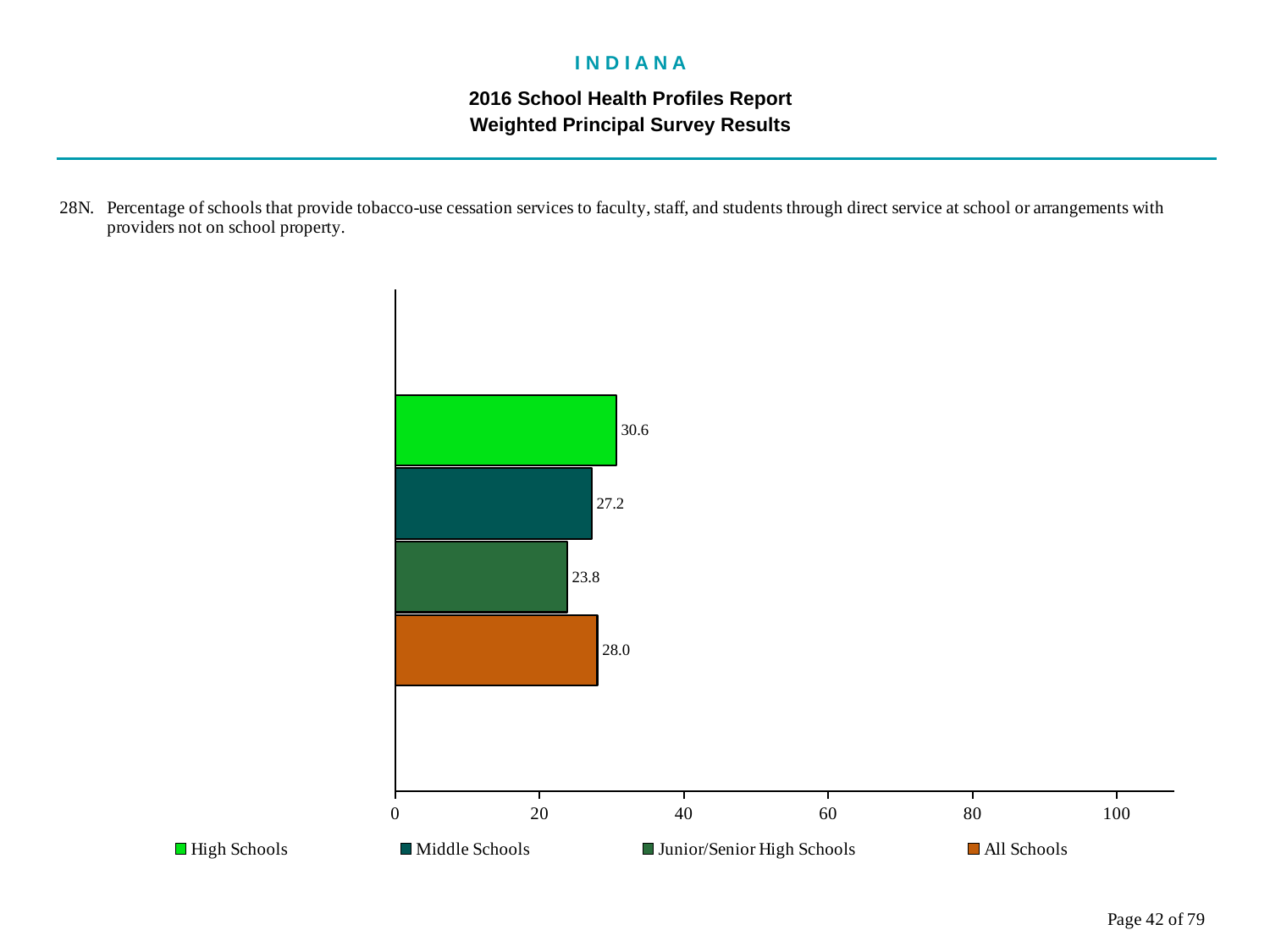
Which is larger, the value for High Schools or the value for Middle Schools? High Schools What is the difference between the High Schools value and the Junior/Senior High Schools value? 6.8 What kind of chart is shown on the slide? bar chart What is the value for Junior/Senior High Schools? 23.8 What is the difference between the All Schools value and the Middle Schools value? 0.8 Which school type has the lowest value? Junior/Senior High Schools What is the value for Middle Schools? 27.2 What is the value for All Schools? 28.0 Which school type has the highest value? High Schools How many series does the legend list? 4 Is the value for High Schools greater or less than 40? less What is the value for High Schools? 30.6